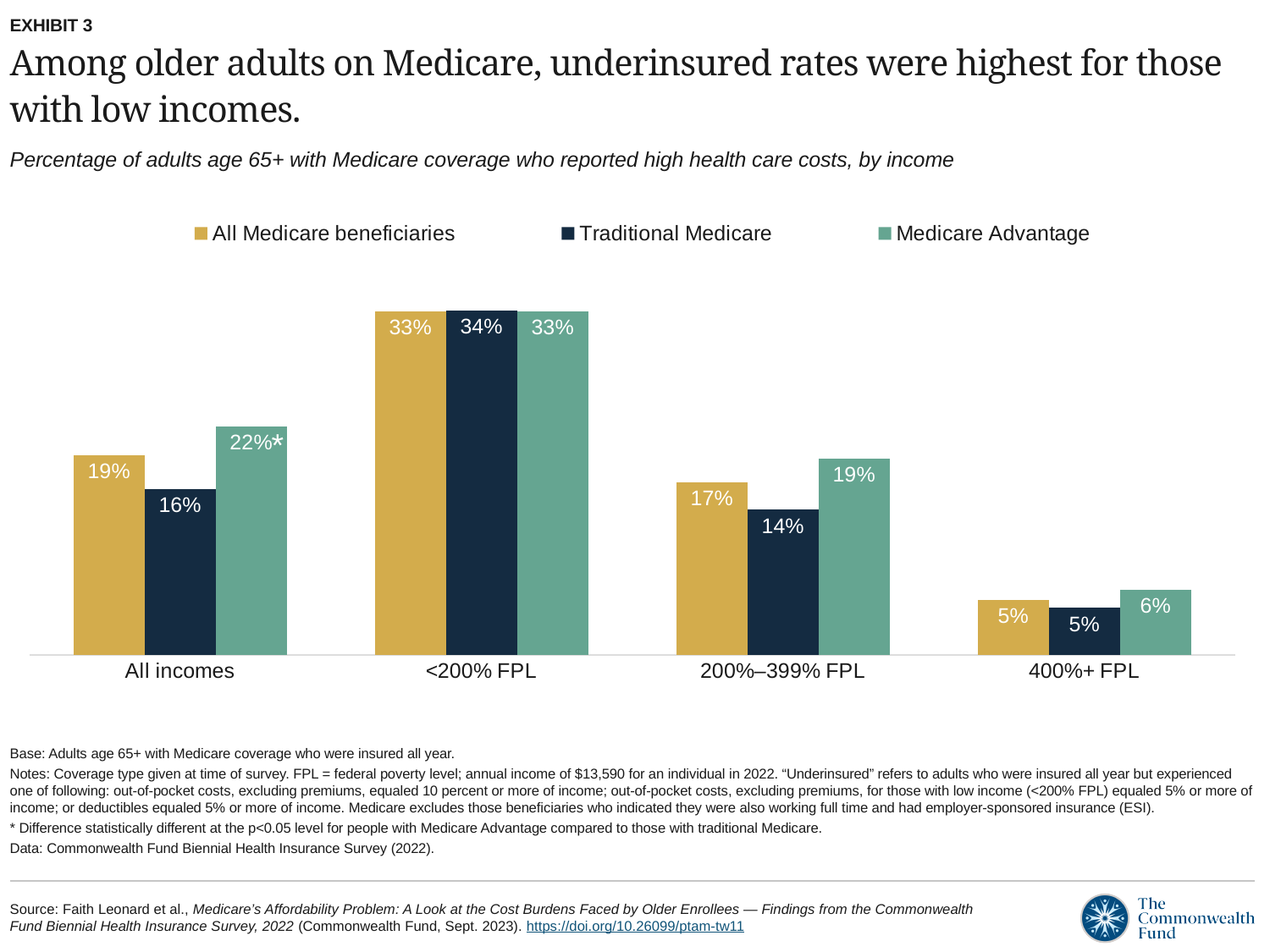
What is the value for Traditional Medicare in the <200% FPL category? 34% Which series is shown in dark navy in the legend? Traditional Medicare Which income category has the lowest value for Traditional Medicare? 400%+ FPL How many series does the legend list? 3 What is the difference between the All Medicare beneficiaries values for <200% FPL and 400%+ FPL? 28% What is the difference between the Medicare Advantage and Traditional Medicare values in the All incomes category? 6% What is the value for Medicare Advantage in the All incomes category? 22% What is the value for All Medicare beneficiaries in the 200%–399% FPL category? 17% In the 200%–399% FPL category, which is larger: Traditional Medicare or Medicare Advantage? Medicare Advantage How many income categories are shown on the x axis? 4 What kind of chart is shown on the slide? Bar chart Which income category has the highest value for All Medicare beneficiaries? <200% FPL